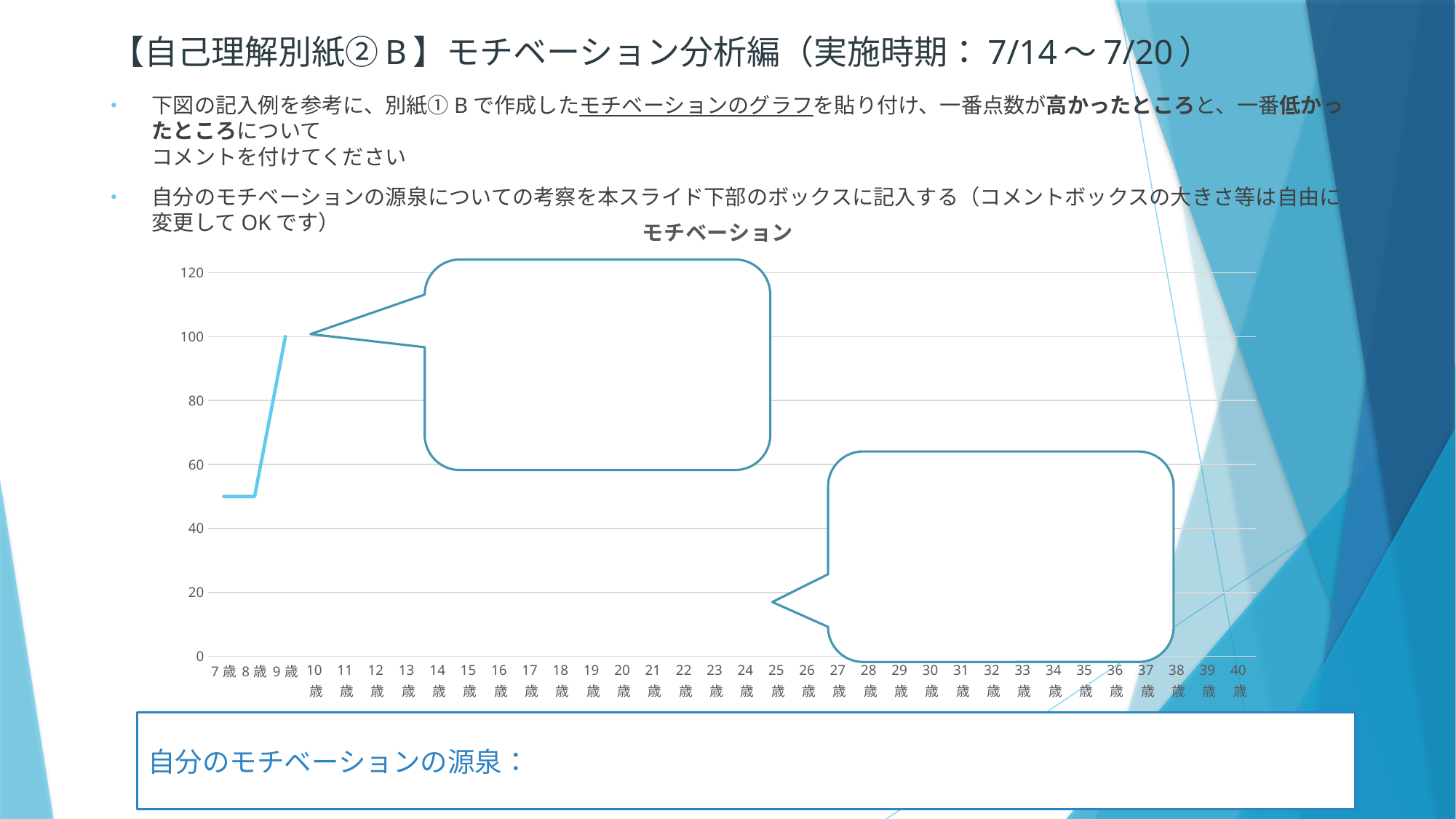
For how many ages is a value actually plotted on the line? 3 Does the line rise or fall from 8歳 to 9歳? rise Which is larger, the value for 8歳 or the value for 9歳? 9歳 What kind of chart is shown on the slide? line chart How many age categories are shown on the x axis? 34 What is the title of the chart? モチベーション Is the value for 9歳 greater or less than 80? greater What is the highest value shown on the y axis? 120 Is the value for 8歳 greater or less than 60? less What is the value plotted for 9歳? 100 Is the value for 7歳 greater or less than 40? greater Which age has the highest plotted value? 9歳